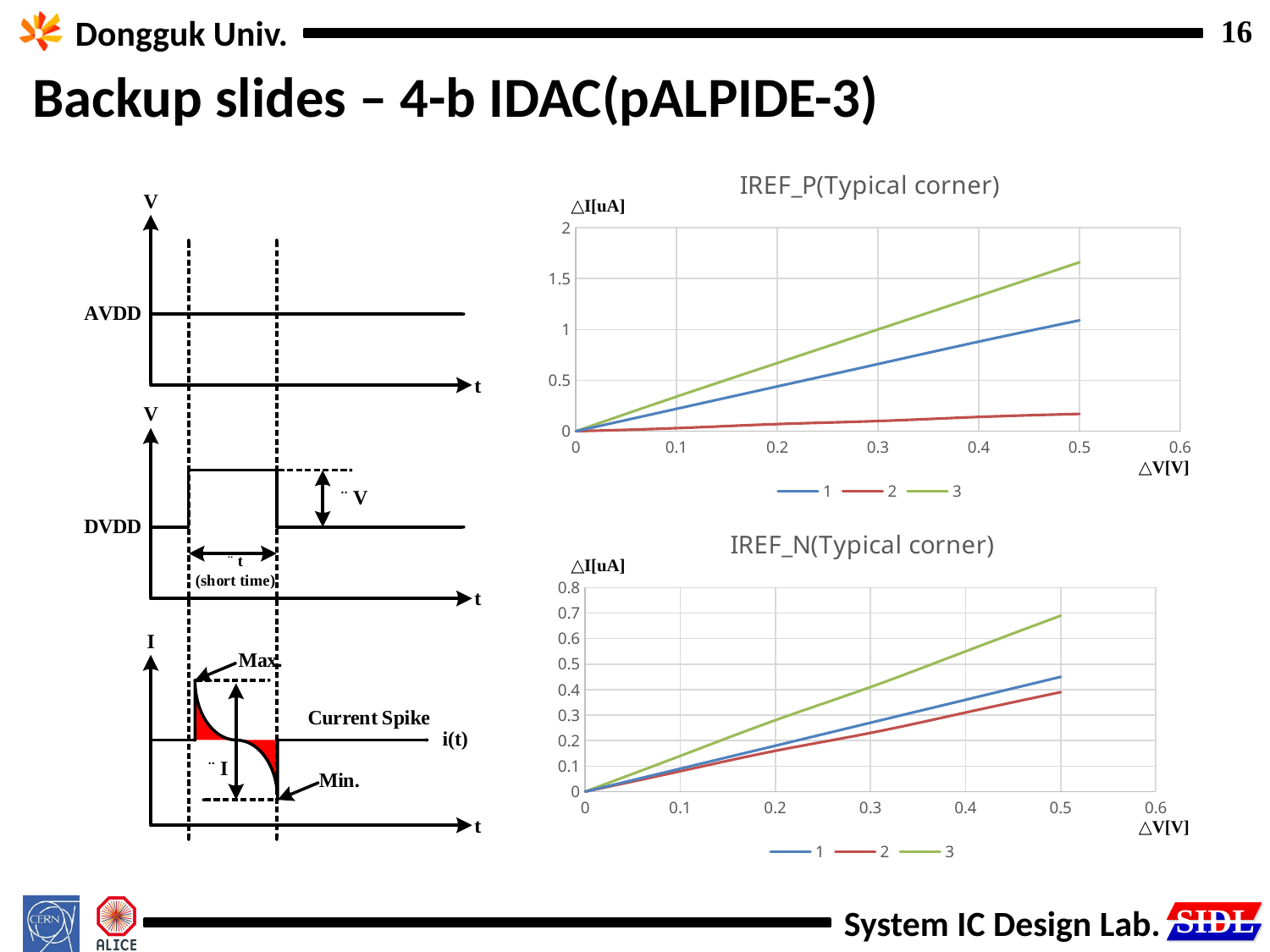
In the IREF_N(Typical corner) chart, which is larger at △V = 0.5: series 1 or series 2? series 1 How many series does the legend of the IREF_N(Typical corner) chart list? 3 In the IREF_P(Typical corner) chart, is the value of series 2 at △V = 0.5 greater or less than 0.5? less In the IREF_P(Typical corner) chart, which series has the highest value at △V = 0.5? 3 In the IREF_P(Typical corner) chart, do the values of series 1 rise or fall as △V increases? rise What is the label of the vertical axis on the IREF_N(Typical corner) chart? △I[uA] In the IREF_N(Typical corner) chart, is the value of series 1 at △V = 0.5 greater or less than 0.5? less What kind of chart is the IREF_P(Typical corner) chart? line chart In the IREF_N(Typical corner) chart, which series has the highest value at △V = 0.5? 3 In the IREF_N(Typical corner) chart, is the value of series 3 at △V = 0.5 greater or less than 0.6? greater In the IREF_P(Typical corner) chart, which series has the lowest value at △V = 0.5? 2